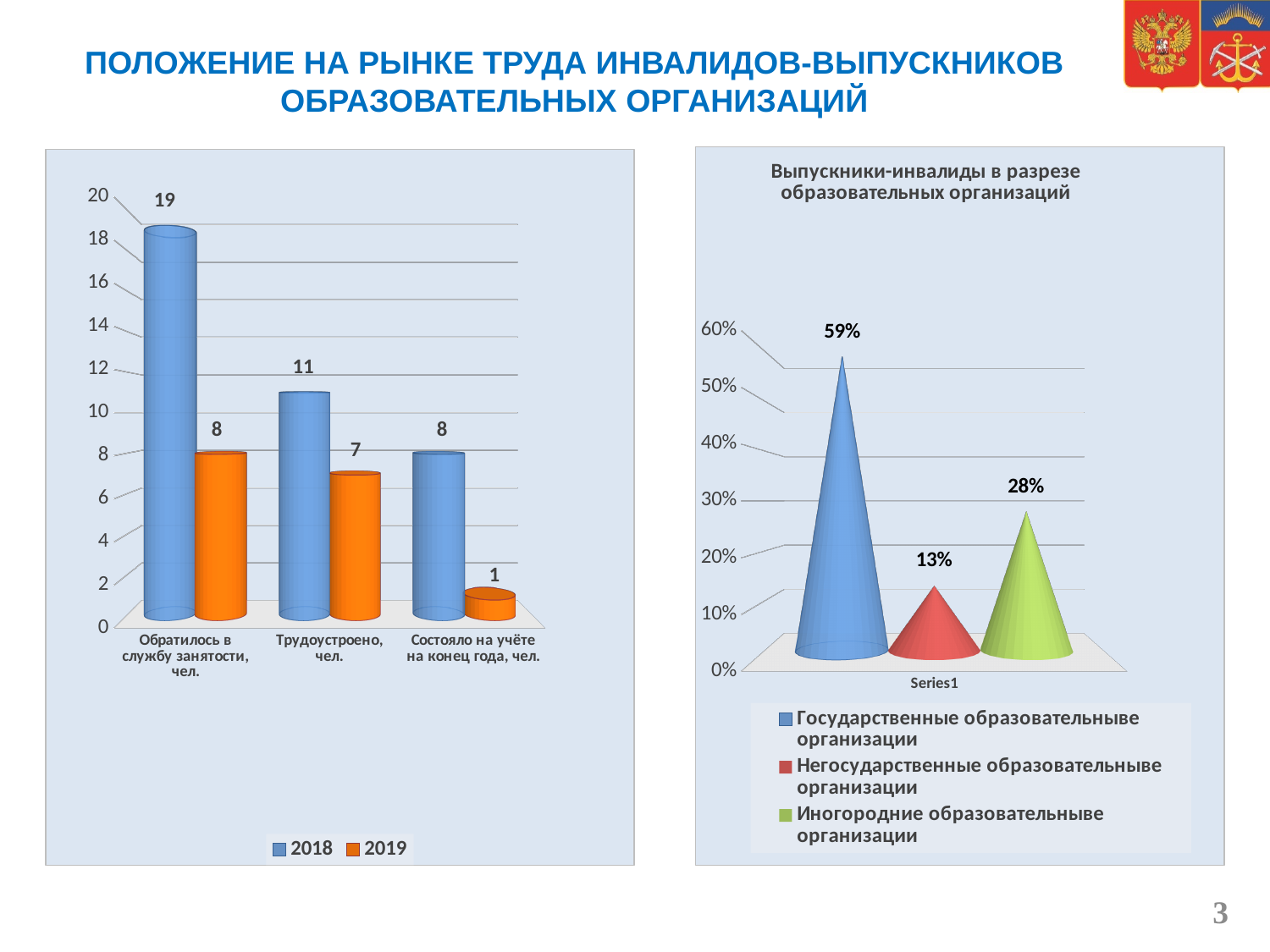
In the left chart, what is the 2019 value for 'Состояло на учёте на конец года, чел.'? 1 In the left chart, what is the 2019 value for 'Трудоустроено, чел.'? 7 In the left chart, which category has the lowest 2019 value? Состояло на учёте на конец года, чел. In the chart 'Выпускники-инвалиды в разрезе образовательных организаций', what is the difference between the values for 'Государственные образовательныве организации' and 'Иногородние образовательныве организации'? 31% In the chart 'Выпускники-инвалиды в разрезе образовательных организаций', what is the value for 'Негосударственные образовательныве организации'? 13% In the left chart, what is the 2018 value for 'Обратилось в службу занятости, чел.'? 19 In the left chart, how many series does the legend list? 2 In the chart 'Выпускники-инвалиды в разрезе образовательных организаций', how many entries does the legend list? 3 In the left chart, how many categories are shown on the x axis? 3 In the left chart, what is the difference between the 2018 and 2019 values for 'Обратилось в службу занятости, чел.'? 11 In the chart 'Выпускники-инвалиды в разрезе образовательных организаций', which category has the highest value? Государственные образовательныве организации In the left chart, which is larger: the 2018 value for 'Трудоустроено, чел.' or the 2018 value for 'Состояло на учёте на конец года, чел.'? 2018 value for 'Трудоустроено, чел.'